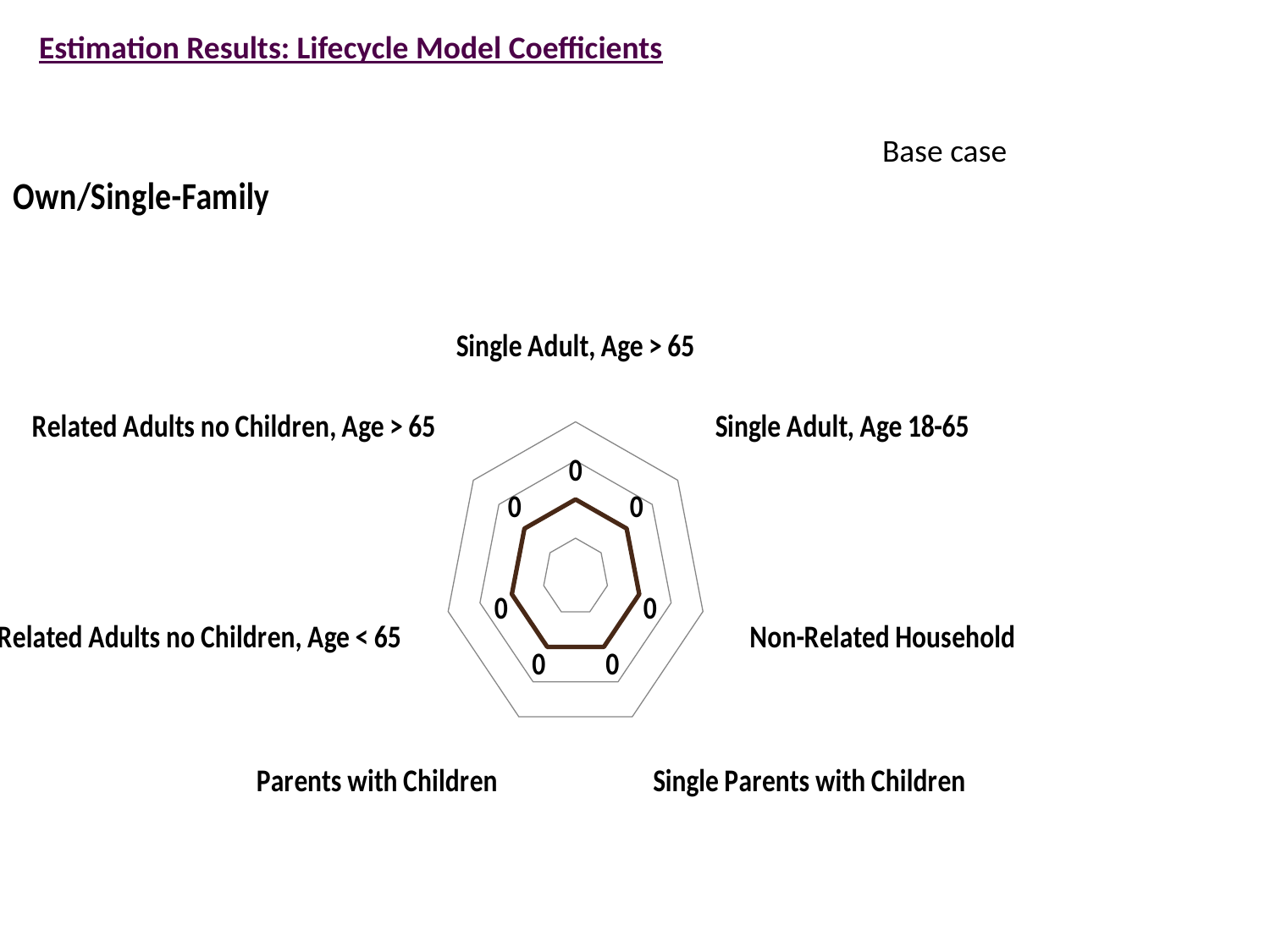
What is the value for Single Adult, Age 18-65? 0 What is the value for Parents with Children? 0 What is the value for Related Adults no Children, Age > 65? 0 What is the difference between the values for Parents with Children and Non-Related Household? 0 What is the value for Non-Related Household? 0 What label appears above the chart to the right, describing the scenario shown? Base case What is the value for Related Adults no Children, Age < 65? 0 What is the title of the chart? Own/Single-Family What is the value for Single Adult, Age > 65? 0 How many categories are plotted on the radar chart? 7 What kind of chart is shown on the slide? Radar chart What is the value for Single Parents with Children? 0